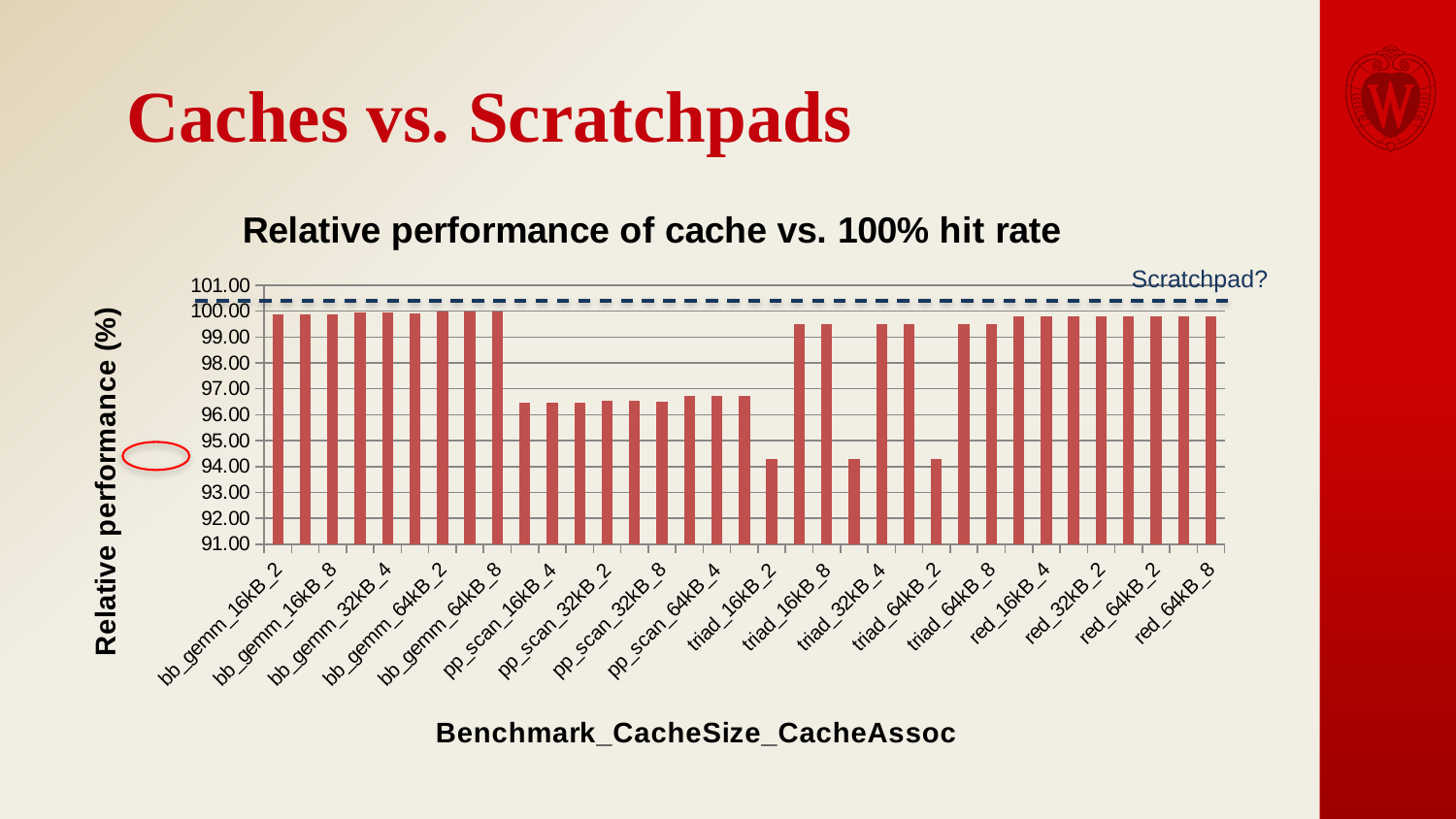
Is the value for bb_gemm_16kB_2 greater or less than 99.00? greater What kind of chart is shown on the slide? bar chart What is the title of the chart? Relative performance of cache vs. 100% hit rate Is the value for pp_scan_16kB_4 greater or less than 97.00? less What is the label of the y axis? Relative performance (%) Is the value for pp_scan_32kB_2 greater or less than 96.00? greater Which is larger, the value for triad_16kB_2 or the value for triad_16kB_8? triad_16kB_8 Which is larger, the value for bb_gemm_16kB_2 or the value for pp_scan_16kB_4? bb_gemm_16kB_2 Which is larger, the value for pp_scan_64kB_4 or the value for red_64kB_8? red_64kB_8